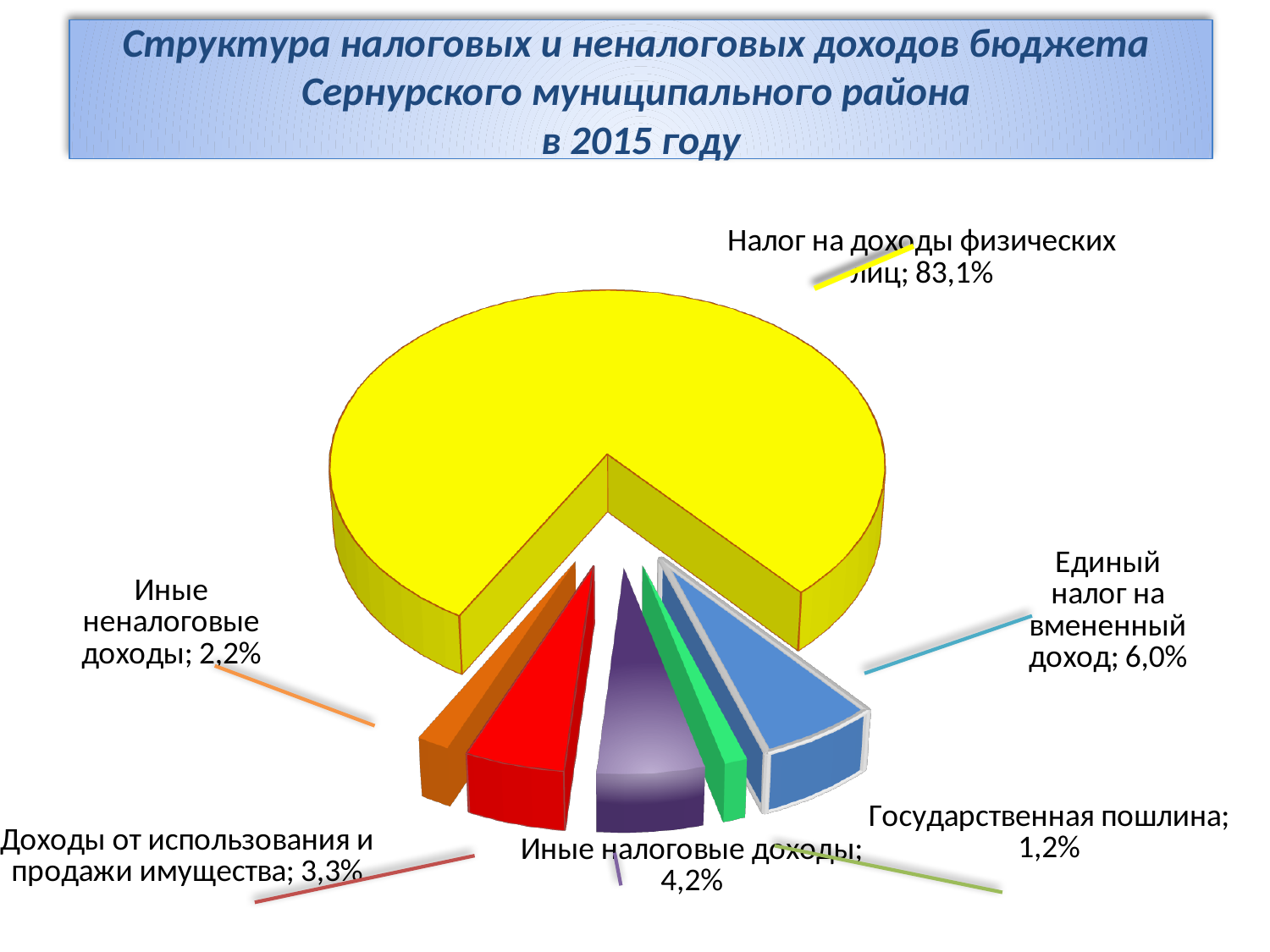
What is the value shown for Единый налог на вмененный доход? 6,0% What is the difference in percentage points between Единый налог на вмененный доход and Иные налоговые доходы? 1,8 How many slices does the pie chart have? 6 What percentage is labelled for Государственная пошлина? 1,2% What share of the pie does Налог на доходы физических лиц have? 83,1% What type of chart is shown on the slide? Pie chart What share is shown for Доходы от использования и продажи имущества? 3,3% Which category has the largest slice of the pie? Налог на доходы физических лиц Which category has the smallest slice of the pie? Государственная пошлина What colour is the slice for Налог на доходы физических лиц? Yellow Which is larger: Доходы от использования и продажи имущества or Иные неналоговые доходы? Доходы от использования и продажи имущества What is the value for Иные налоговые доходы? 4,2%